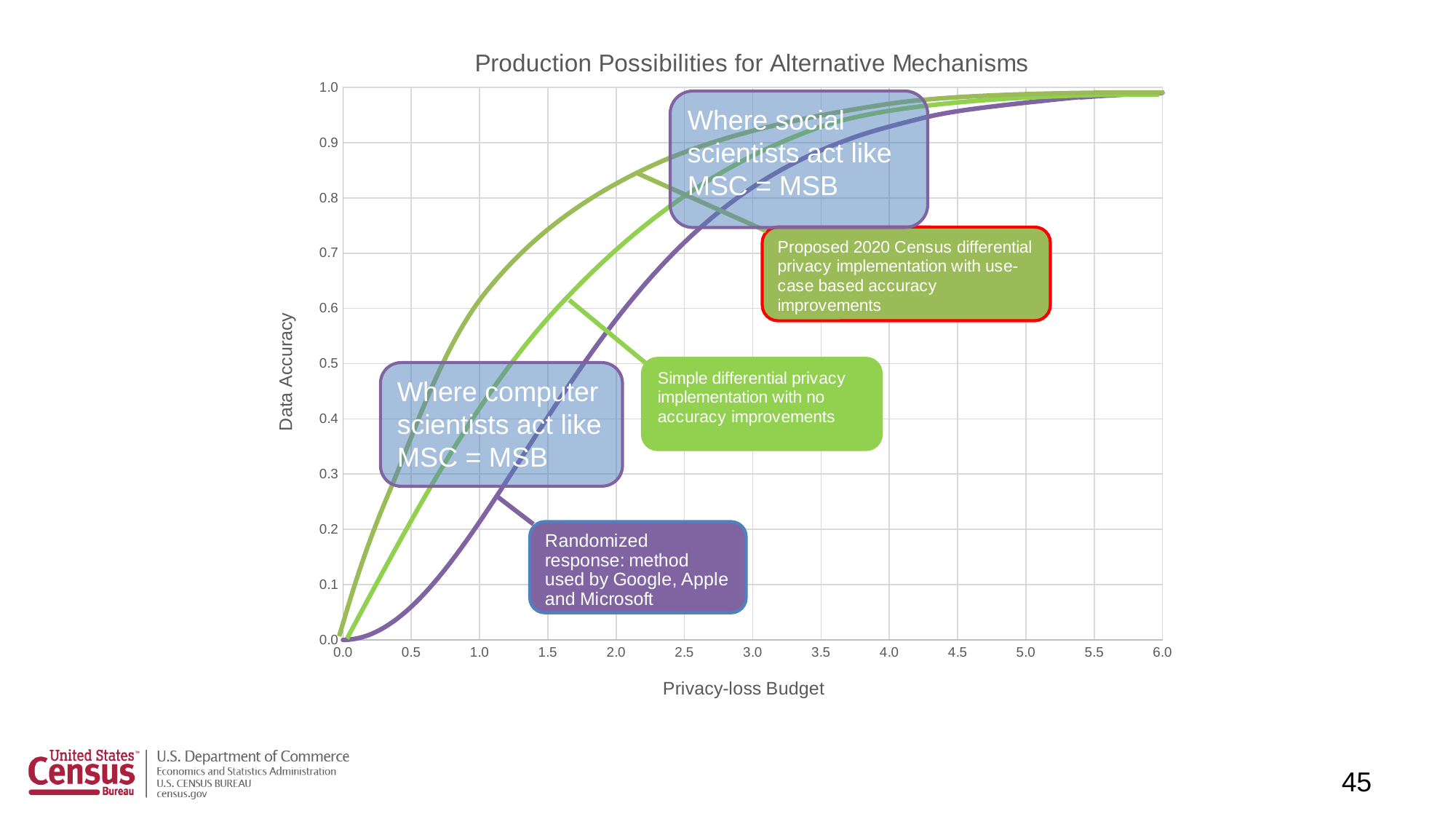
Is the data accuracy of the randomized response curve at a privacy-loss budget of 1.0 greater or less than 0.3? less What kind of chart is shown on the slide? Line chart At a privacy-loss budget of 1.0, which curve has the highest data accuracy? Proposed 2020 Census differential privacy implementation with use-case based accuracy improvements At a privacy-loss budget of 1.5, which curve has higher data accuracy: the simple differential privacy curve or the randomized response curve? Simple differential privacy implementation with no accuracy improvements At a privacy-loss budget of 1.0, which curve has the lowest data accuracy? Randomized response: method used by Google, Apple and Microsoft What is the title of the chart? Production Possibilities for Alternative Mechanisms How many curves are plotted on the chart? 3 What is the data accuracy of the curves at a privacy-loss budget of 0.0? 0.0 What is the label of the x axis of the chart? Privacy-loss Budget Do the curves rise or fall as the privacy-loss budget increases? Rise Is the data accuracy of the simple differential privacy curve at a privacy-loss budget of 1.0 greater or less than 0.5? less Is the data accuracy of the proposed 2020 Census curve at a privacy-loss budget of 2.0 greater or less than 0.7? greater